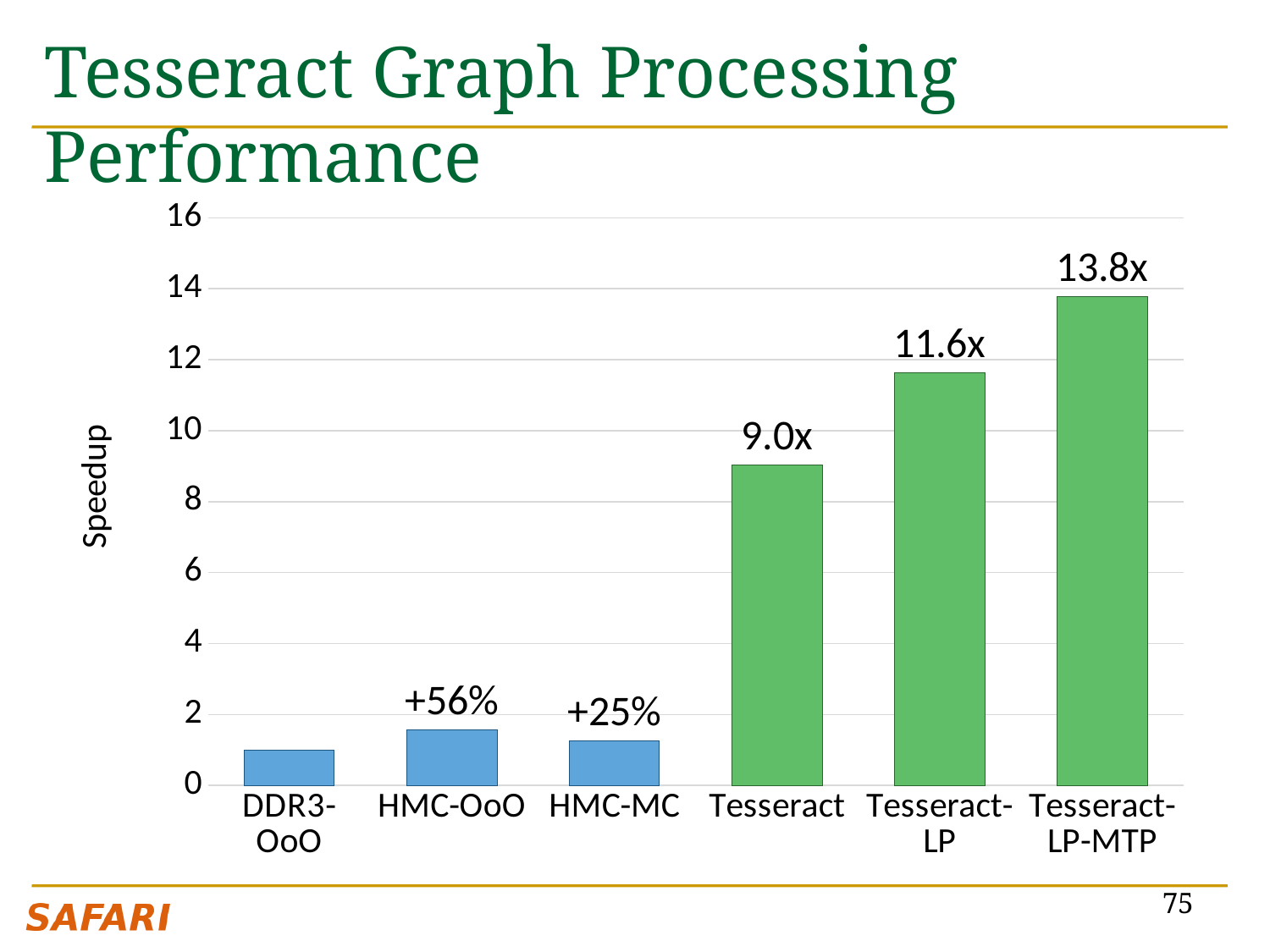
What is the speedup value labelled for Tesseract-LP? 11.6x What is the title of the y axis? Speedup What kind of chart is shown on the slide? bar chart Which has a larger speedup, Tesseract-LP or Tesseract? Tesseract-LP How many categories are plotted on the x axis? 6 What is the difference between the speedup of Tesseract-LP-MTP and Tesseract? 4.8x What is the speedup value labelled for Tesseract? 9.0x Is the value for HMC-OoO greater or less than 2? less Do the values generally rise or fall from left to right along the x axis? rise What is the speedup value labelled for Tesseract-LP-MTP? 13.8x Which category has the lowest speedup? DDR3-OoO Which category has the highest speedup? Tesseract-LP-MTP